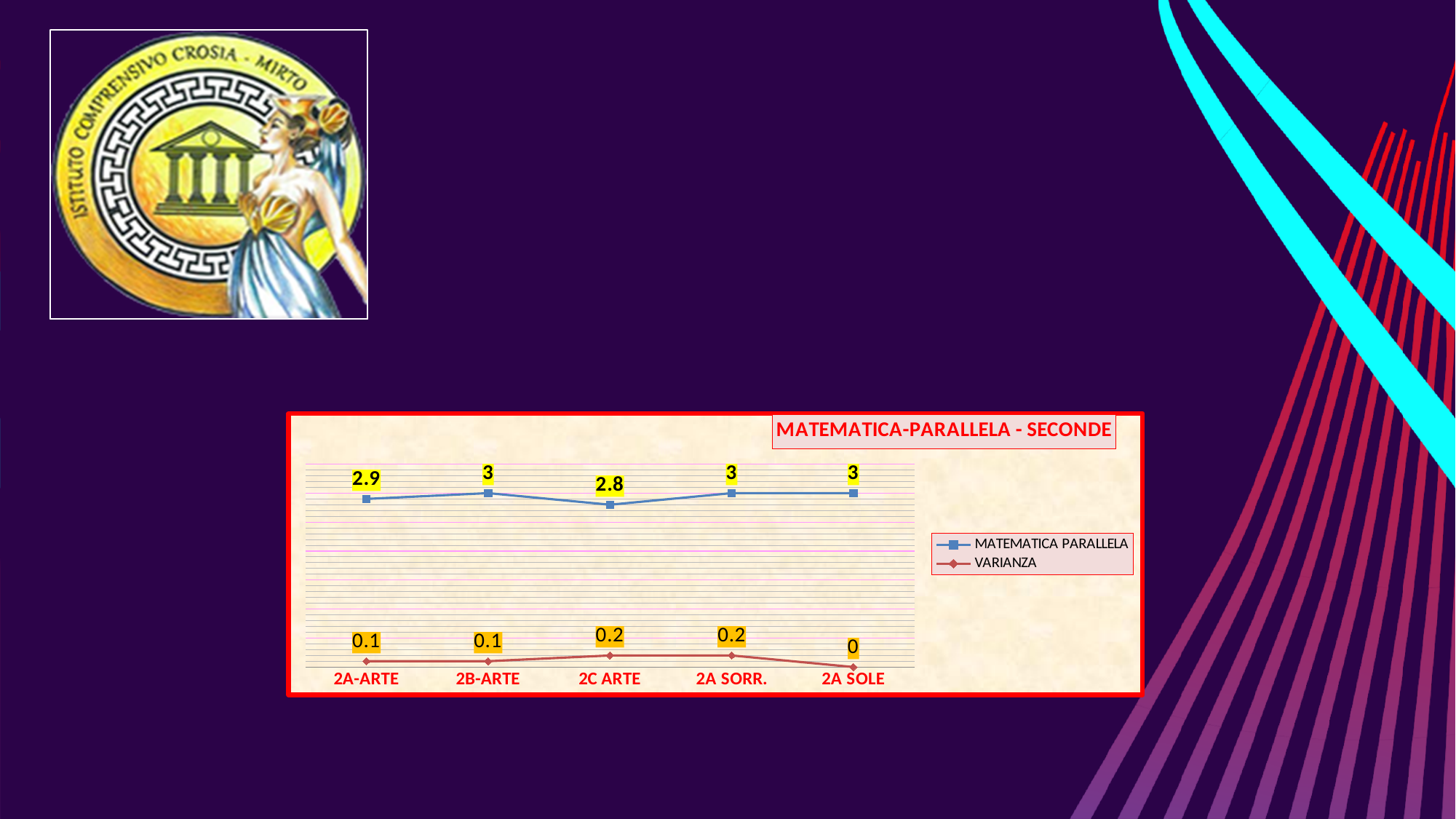
Which category has the lowest MATEMATICA PARALLELA value? 2C ARTE What is the MATEMATICA PARALLELA value for 2C ARTE? 2.8 What is the difference between the MATEMATICA PARALLELA values for 2B-ARTE and 2C ARTE? 0.2 What is the title of the chart? MATEMATICA-PARALLELA - SECONDE Which is larger, the VARIANZA value for 2C ARTE or for 2B-ARTE? 2C ARTE What is the MATEMATICA PARALLELA value for 2A-ARTE? 2.9 How many categories are shown on the x axis? 5 What is the VARIANZA value for 2A SORR.? 0.2 How many series does the legend list? 2 What is the VARIANZA value for 2A SOLE? 0 Which category has the lowest VARIANZA value? 2A SOLE What kind of chart is shown? Line chart